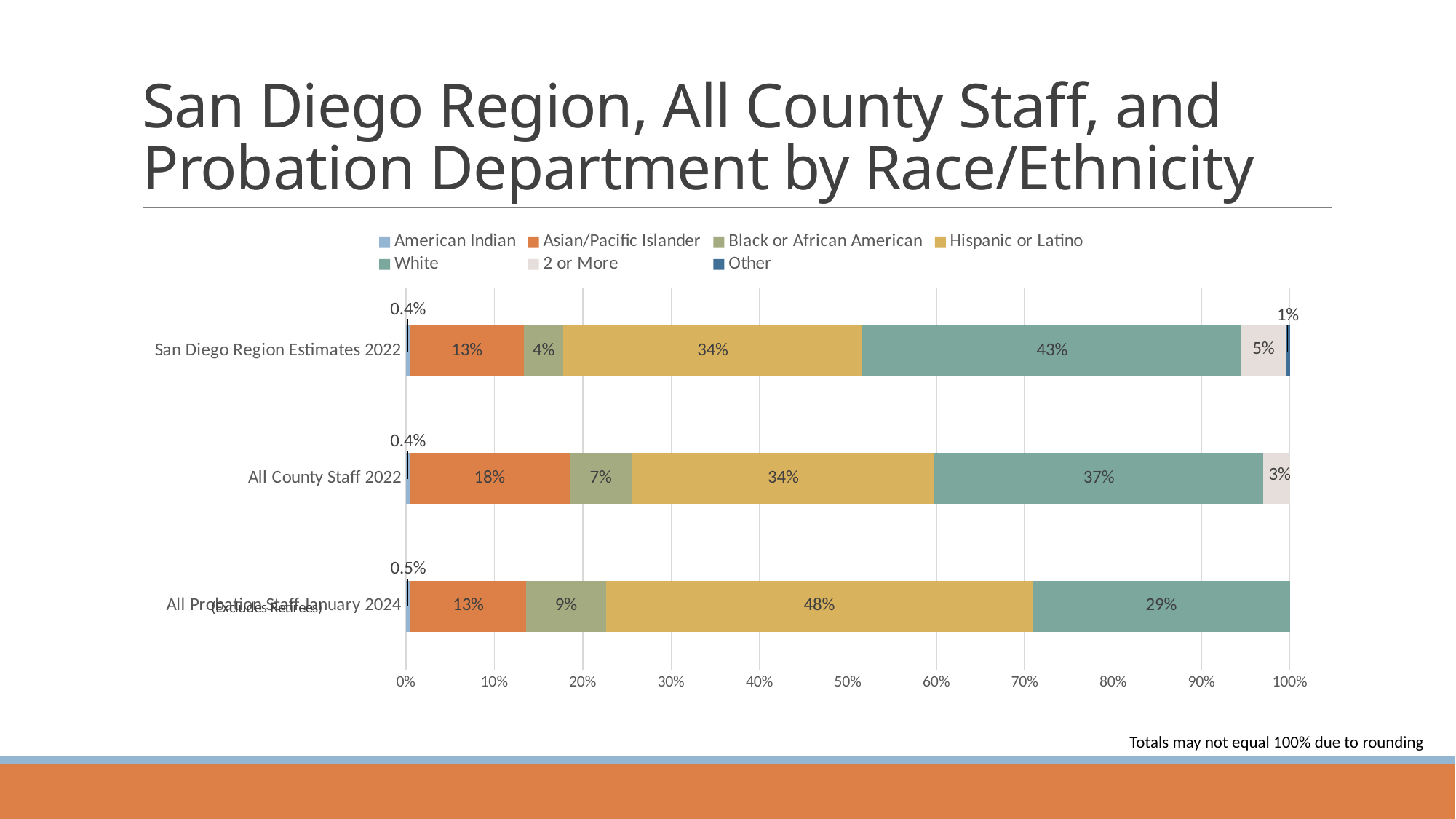
What kind of chart is shown on the slide? Stacked bar chart What is the difference between the White share for San Diego Region Estimates 2022 and for All Probation Staff January 2024? 14% How many categories (bars) are plotted on the chart? 3 What is the 2 or More share for All County Staff 2022? 3% Which category has the lowest White share? All Probation Staff January 2024 What is the Hispanic or Latino share for All Probation Staff January 2024? 48% How many series does the legend list? 7 What is the Asian/Pacific Islander share for All County Staff 2022? 18% What is the White share for San Diego Region Estimates 2022? 43% Which category has the highest Hispanic or Latino share? All Probation Staff January 2024 What is the American Indian share for All Probation Staff January 2024? 0.5% Which is larger: the Black or African American share for All County Staff 2022 or for All Probation Staff January 2024? All Probation Staff January 2024